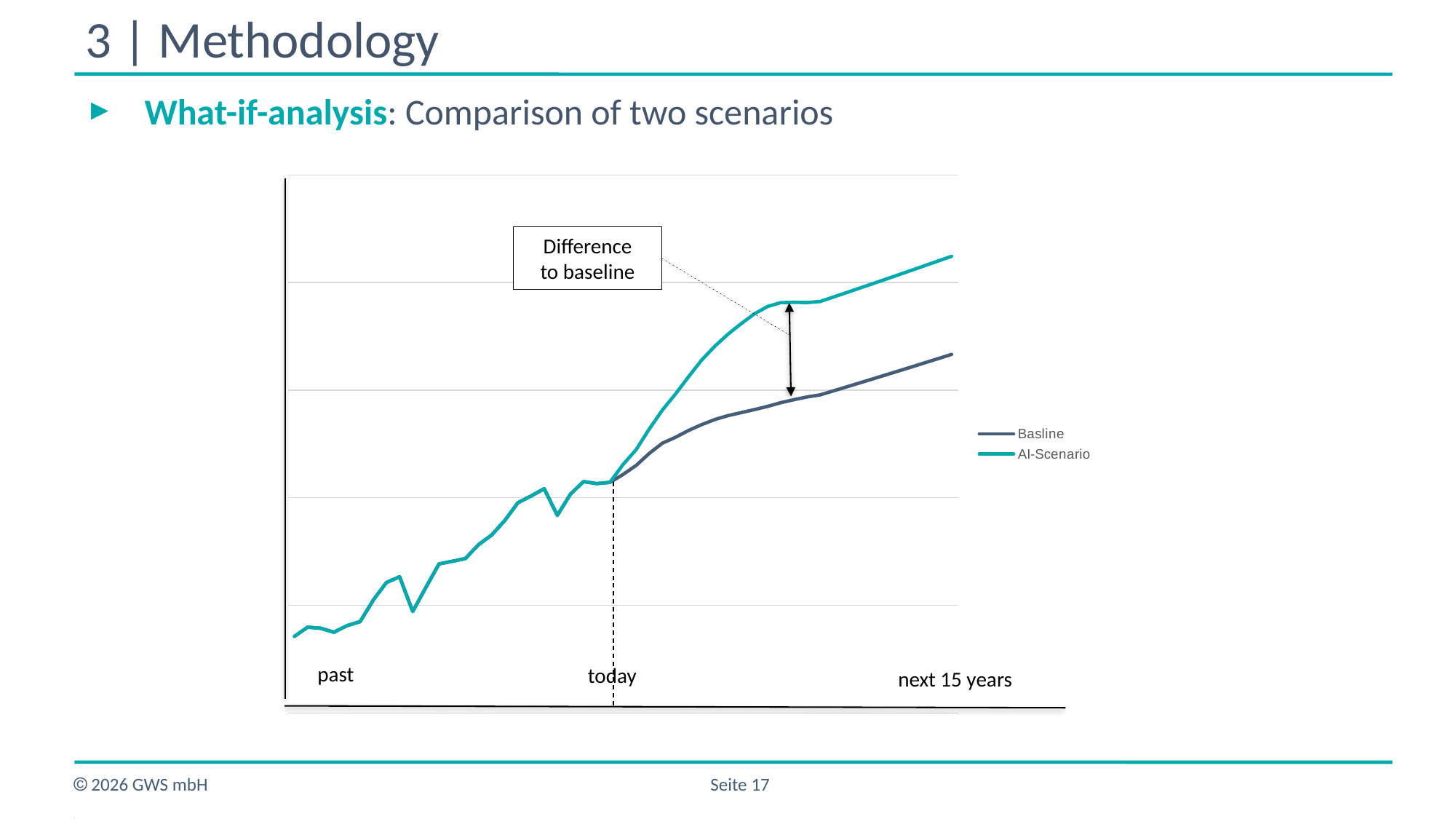
Which series is higher at the right end of the chart, Basline or AI-Scenario? AI-Scenario Do the values of the AI-Scenario line rise or fall from 'today' to the right end of the chart? rise How many series does the legend list? 2 Which two series are listed in the chart legend? Basline and AI-Scenario Do the values of the Basline line rise or fall from 'today' to the right end of the chart? rise Which series is drawn in teal? AI-Scenario What kind of chart is shown on the slide? line chart Overall, does the teal line rise or fall from the 'past' label to the 'today' label? rise What does the text box with the arrow pointing between the two lines say? Difference to baseline